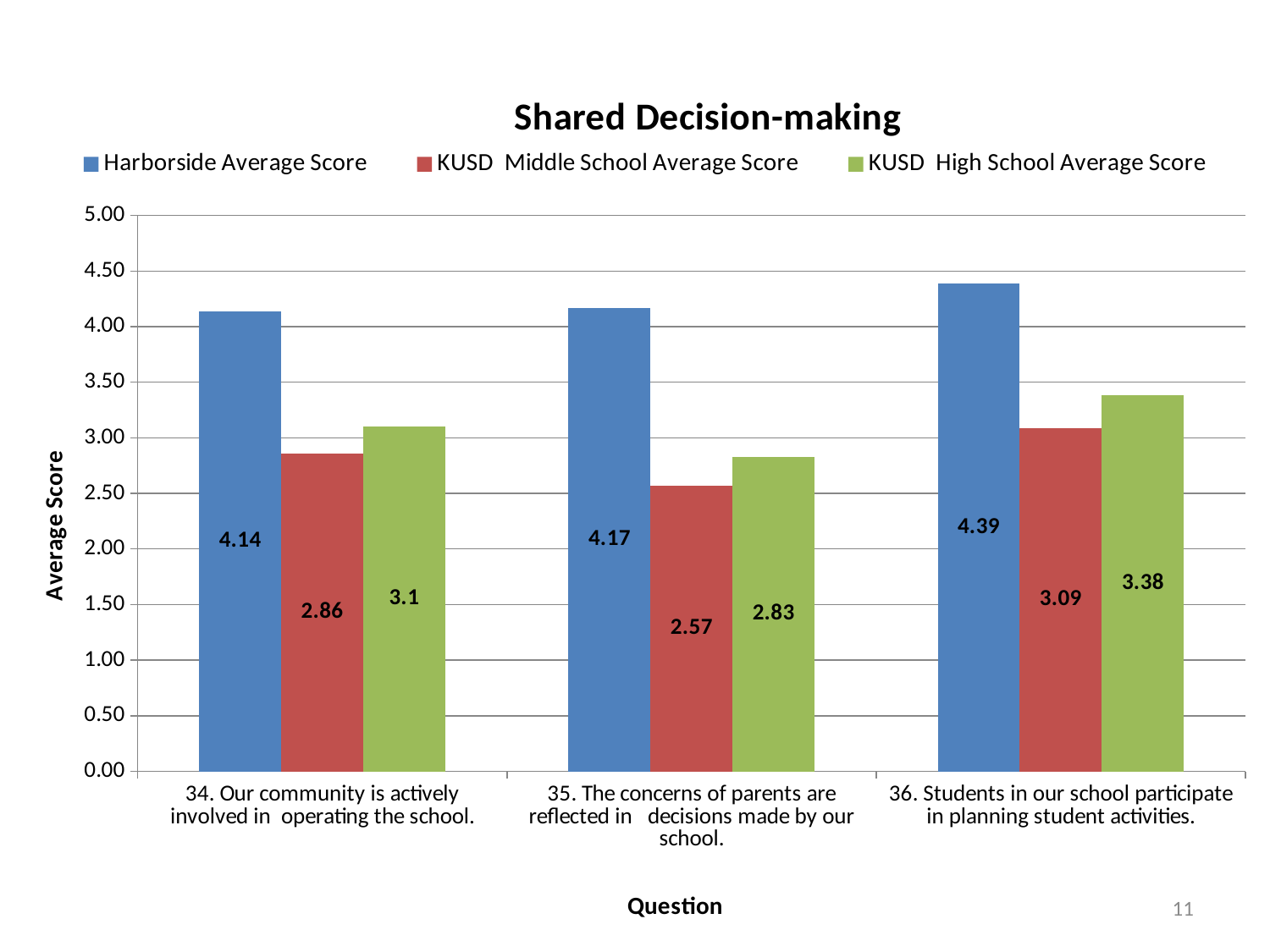
For question 34, which is larger: the KUSD Middle School Average Score or the KUSD High School Average Score? KUSD High School Average Score How many questions are shown on the x axis? 3 What is the KUSD High School Average Score for question 36? 3.38 Which question has the lowest KUSD Middle School Average Score? 35. The concerns of parents are reflected in decisions made by our school. What is the title of the chart? Shared Decision-making What is the KUSD Middle School Average Score for question 35? 2.57 Which question has the highest Harborside Average Score? 36. Students in our school participate in planning student activities. What kind of chart is shown? bar chart What is the difference between the Harborside Average Score and the KUSD High School Average Score for question 36? 1.01 What is the Harborside Average Score for question 34? 4.14 How many series does the legend list? 3 Is the KUSD Middle School Average Score for question 36 greater or less than 3.00? greater